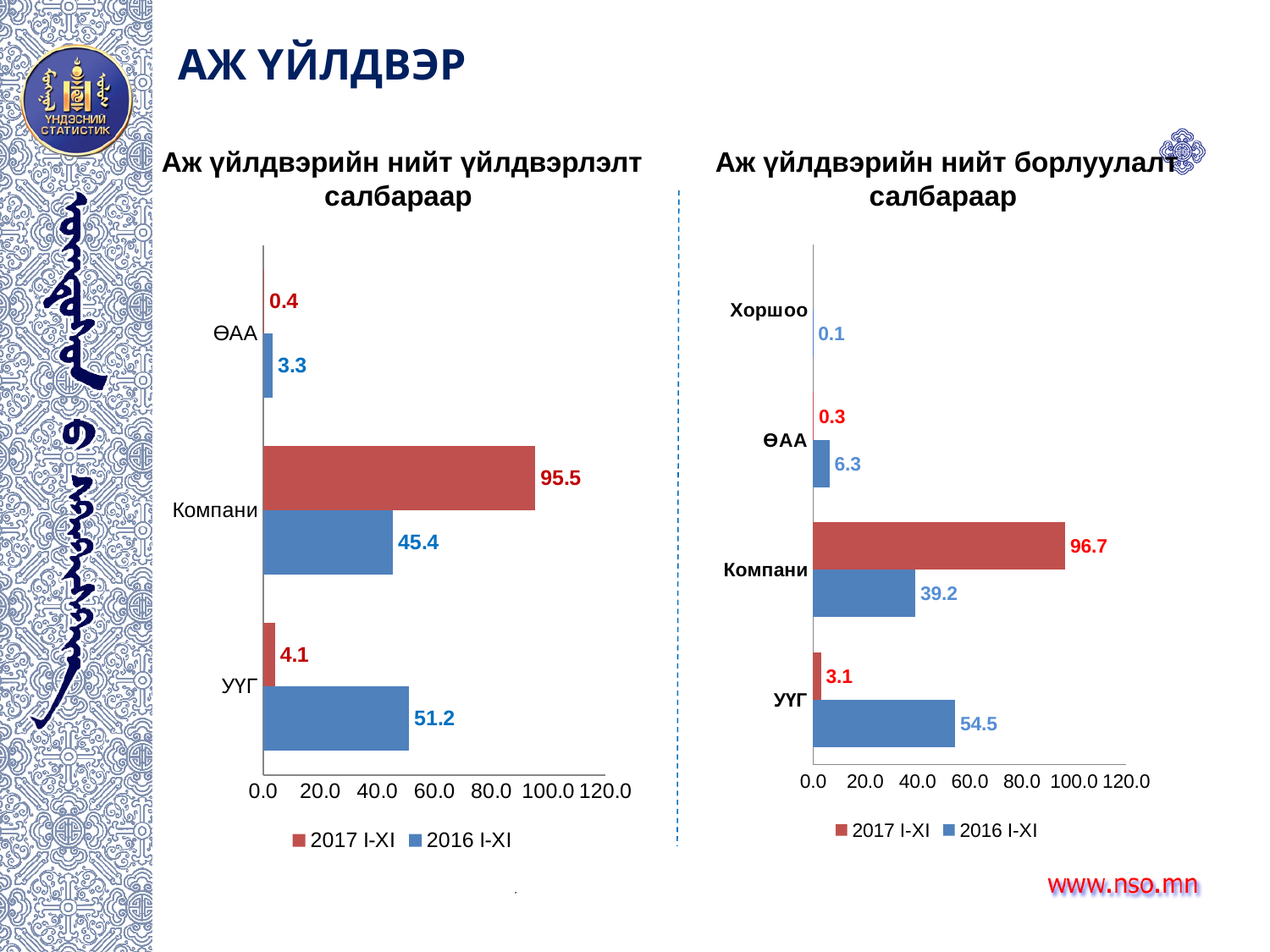
In the left chart (Аж үйлдвэрийн нийт үйлдвэрлэлт салбараар), how many categories are shown? 3 In the left chart (Аж үйлдвэрийн нийт үйлдвэрлэлт салбараар), which category has the highest 2016 I-XI value? УҮГ In the right chart (Аж үйлдвэрийн нийт борлуулалт салбараар), how many categories are shown? 4 In the right chart (Аж үйлдвэрийн нийт борлуулалт салбараар), which category has the lowest 2016 I-XI value? Хоршоо In the left chart (Аж үйлдвэрийн нийт үйлдвэрлэлт салбараар), what is the 2017 I-XI value for Компани? 95.5 In the left chart (Аж үйлдвэрийн нийт үйлдвэрлэлт салбараар), what is the 2016 I-XI value for УҮГ? 51.2 What type of chart is the left chart (Аж үйлдвэрийн нийт үйлдвэрлэлт салбараар)? Bar chart How many series does the legend of the right chart (Аж үйлдвэрийн нийт борлуулалт салбараар) list? 2 In the right chart (Аж үйлдвэрийн нийт борлуулалт салбараар), what is the 2016 I-XI value for Компани? 39.2 In the right chart (Аж үйлдвэрийн нийт борлуулалт салбараар), what is the 2017 I-XI value for УҮГ? 3.1 In the left chart (Аж үйлдвэрийн нийт үйлдвэрлэлт салбараар), what is the difference between the 2017 I-XI and 2016 I-XI values for Компани? 50.1 In the right chart (Аж үйлдвэрийн нийт борлуулалт салбараар), which is larger for ӨАА: the 2017 I-XI value or the 2016 I-XI value? 2016 I-XI